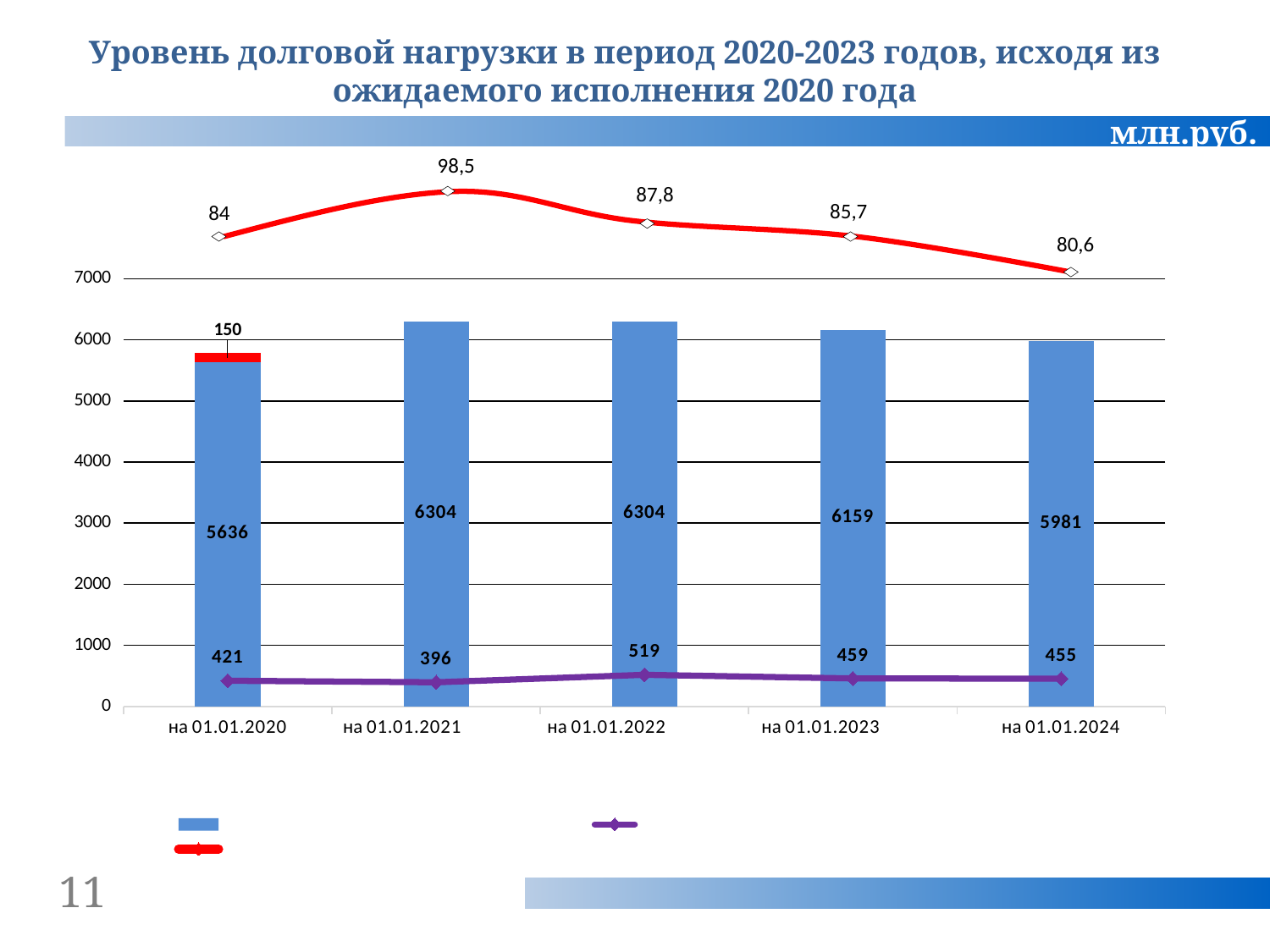
What is the value printed on the blue bar for на 01.01.2024? 5981 How many categories are shown on the x axis? 5 What is the total of the stacked bar for на 01.01.2020 (blue segment plus red segment)? 5786 At which category does the red line reach its highest value? на 01.01.2021 Which is larger: the purple line value at на 01.01.2023 or at на 01.01.2024? на 01.01.2023 What is the value printed on the blue bar for на 01.01.2021? 6304 What is the difference between the blue bar values for на 01.01.2022 and на 01.01.2023? 145 What value is printed on the red line at на 01.01.2021? 98,5 Which category has the lowest value on the blue bars? на 01.01.2020 Does the red line rise or fall from на 01.01.2021 to на 01.01.2024? fall What value is printed on the purple line at на 01.01.2022? 519 At which category does the purple line have its lowest value? на 01.01.2021